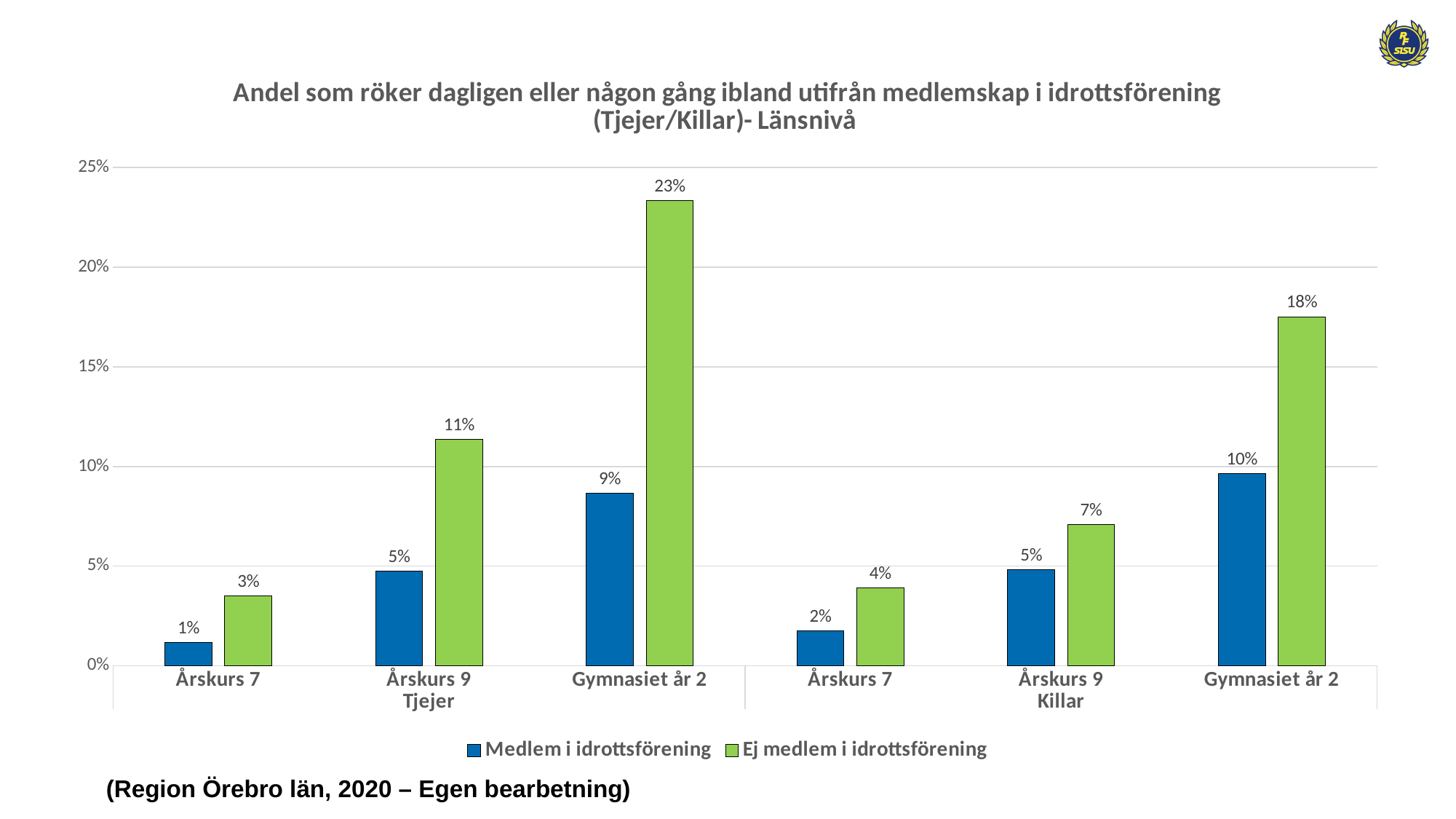
What is the value for "Ej medlem i idrottsförening" for Gymnasiet år 2 among Tjejer? 23% How many series does the legend list? 2 Which is larger: "Ej medlem i idrottsförening" for Gymnasiet år 2 among Tjejer or among Killar? Tjejer Do the values for "Ej medlem i idrottsförening" rise or fall from Årskurs 7 to Gymnasiet år 2 among Killar? Rise What is the difference between "Ej medlem i idrottsförening" and "Medlem i idrottsförening" for Gymnasiet år 2 among Tjejer? 14% What is the value for "Medlem i idrottsförening" for Årskurs 7 among Killar? 2% What is the value for "Ej medlem i idrottsförening" for Årskurs 9 among Tjejer? 11% How many category groups are shown on the x axis? 6 What kind of chart is shown on the slide? Bar chart Which group has the highest value for "Ej medlem i idrottsförening"? Gymnasiet år 2 (Tjejer) What is the value for "Medlem i idrottsförening" for Gymnasiet år 2 among Killar? 10% Which group has the lowest value for "Medlem i idrottsförening"? Årskurs 7 (Tjejer)